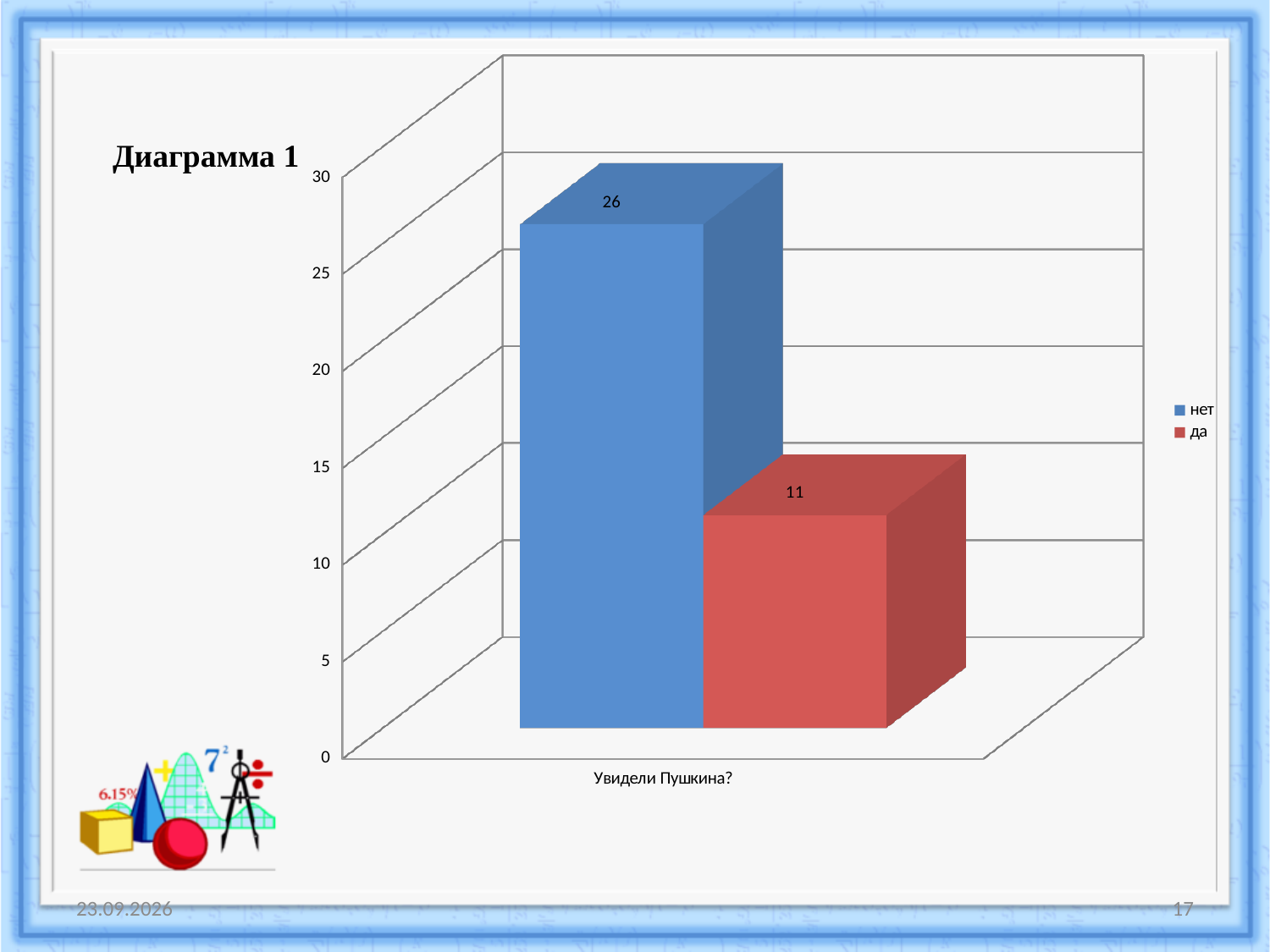
Is the value for "нет" greater or less than 20? greater Is the value for "нет" larger than the value for "да"? Yes What is the value for "да" in the chart? 11 What is the difference between the values for "нет" and "да"? 15 What is the title of the chart? Диаграмма 1 What is the category label on the x axis of the chart? Увидели Пушкина? Is the value for "да" greater or less than 15? less What is the value for "нет" in the chart? 26 Which series has the higher value, "нет" or "да"? нет Which series has the lower value in the chart? да What kind of chart is shown on the slide? Bar chart How many series does the legend list? 2